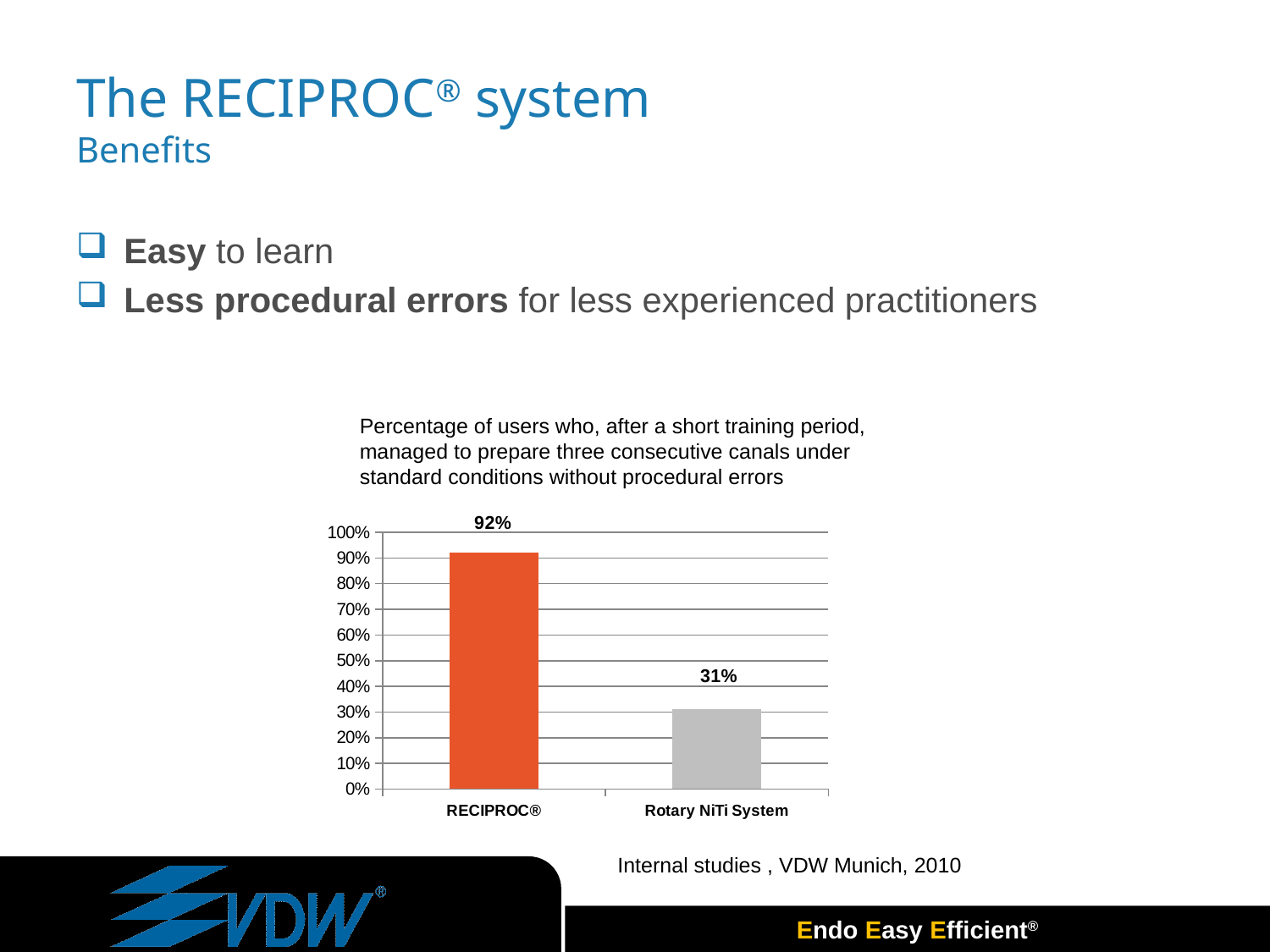
What is the value for Rotary NiTi System in the chart? 31% What is the value for RECIPROC® in the chart? 92% What is the maximum value shown on the chart's vertical axis? 100% Which category has the lowest value in the chart? Rotary NiTi System Is the value for RECIPROC® greater or less than 80%? greater What colour is the bar for RECIPROC®? orange What kind of chart is shown on the slide? bar chart Which category has the highest value in the chart? RECIPROC® What is the difference between the values for RECIPROC® and Rotary NiTi System? 61% Which is larger, the value for RECIPROC® or the value for Rotary NiTi System? RECIPROC® Is the value for Rotary NiTi System greater or less than 50%? less How many categories are shown in the chart? 2